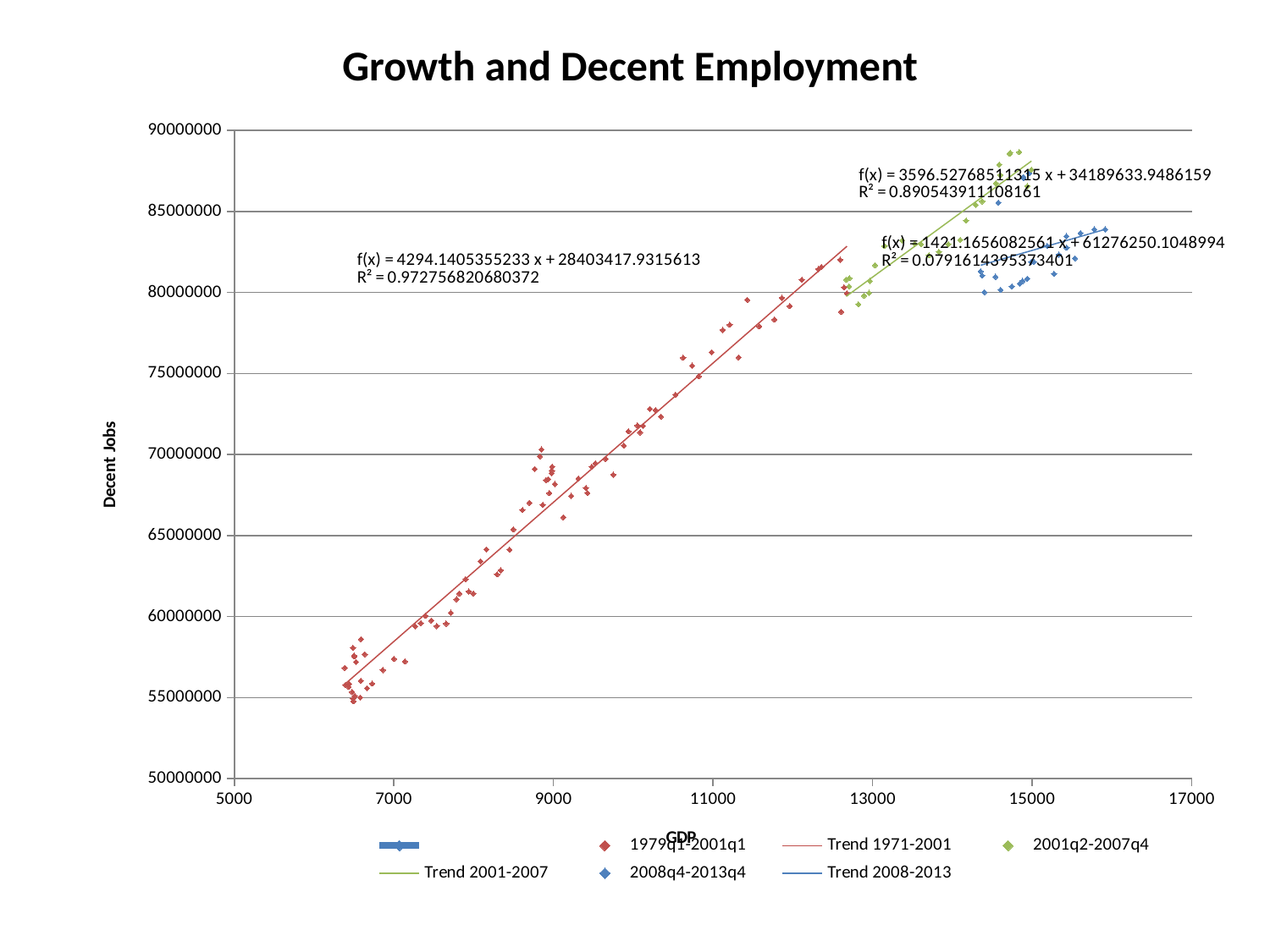
What is the R² value shown for the trend line with equation f(x) = 1421.1656082561 x + 61276250.1048994? 0.0791614395373401 What is the R² value shown for the trend line with equation f(x) = 3596.52768511315 x + 34189633.9486159? 0.890543911108161 What kind of chart is shown on the slide? scatter chart What is the R² value shown for the trend line with equation f(x) = 4294.1405355233 x + 28403417.9315613? 0.972756820680372 Which of the three trend-line equations on the chart has the highest R² value? f(x) = 4294.1405355233 x + 28403417.9315613 What is the label of the vertical axis? Decent Jobs Is the R² of 0.972756820680372 larger or smaller than the R² of 0.890543911108161? larger For the 1979q1-2001q1 series, do Decent Jobs rise or fall as GDP increases? rise Which of the three trend-line equations on the chart has the lowest R² value? f(x) = 1421.1656082561 x + 61276250.1048994 Are the Decent Jobs values for the 2008q4-2013q4 series greater or less than 75000000? greater Which data series reaches the highest Decent Jobs values on the chart? 2001q2-2007q4 What is the title of the chart? Growth and Decent Employment